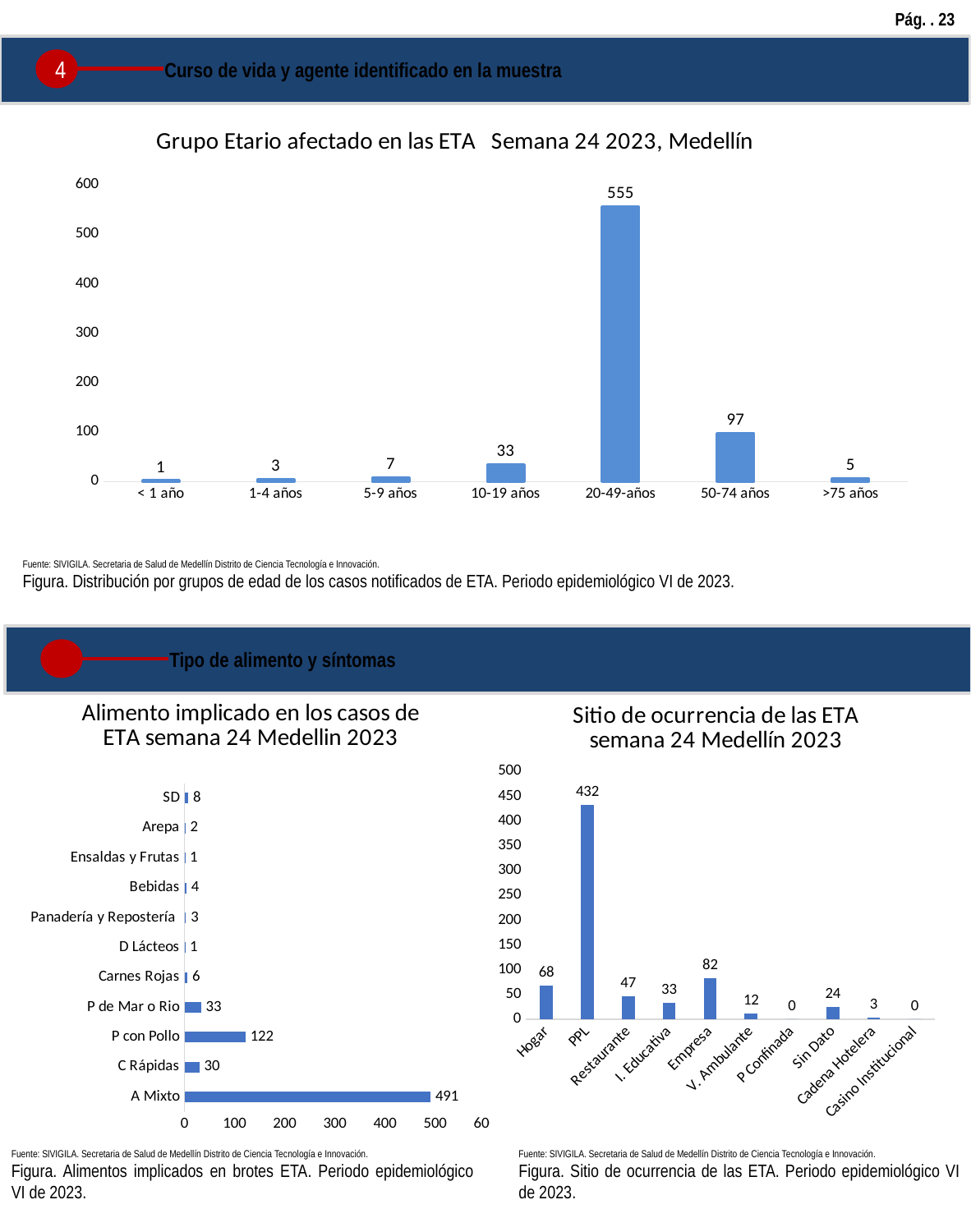
In the chart 'Sitio de ocurrencia de las ETA semana 24 Medellín 2023', what is the value for Empresa? 82 In the chart 'Sitio de ocurrencia de las ETA semana 24 Medellín 2023', which site has the highest value? PPL In the chart 'Alimento implicado en los casos de ETA semana 24 Medellin 2023', which is larger, P de Mar o Rio or C Rápidas? P de Mar o Rio What type of chart is 'Grupo Etario afectado en las ETA Semana 24 2023, Medellín'? Bar chart In the chart 'Alimento implicado en los casos de ETA semana 24 Medellin 2023', what is the value for P con Pollo? 122 In the chart 'Grupo Etario afectado en las ETA Semana 24 2023, Medellín', what is the difference between the 50-74 años and 10-19 años values? 64 In the chart 'Alimento implicado en los casos de ETA semana 24 Medellin 2023', which food category has the highest value? A Mixto How many age groups are shown in the chart 'Grupo Etario afectado en las ETA Semana 24 2023, Medellín'? 7 In the chart 'Grupo Etario afectado en las ETA Semana 24 2023, Medellín', which age group has the lowest value? < 1 año How many food categories are shown in the chart 'Alimento implicado en los casos de ETA semana 24 Medellin 2023'? 11 In the chart 'Grupo Etario afectado en las ETA Semana 24 2023, Medellín', what is the value for the 20-49-años group? 555 In the chart 'Sitio de ocurrencia de las ETA semana 24 Medellín 2023', what is the difference between the Hogar and Restaurante values? 21